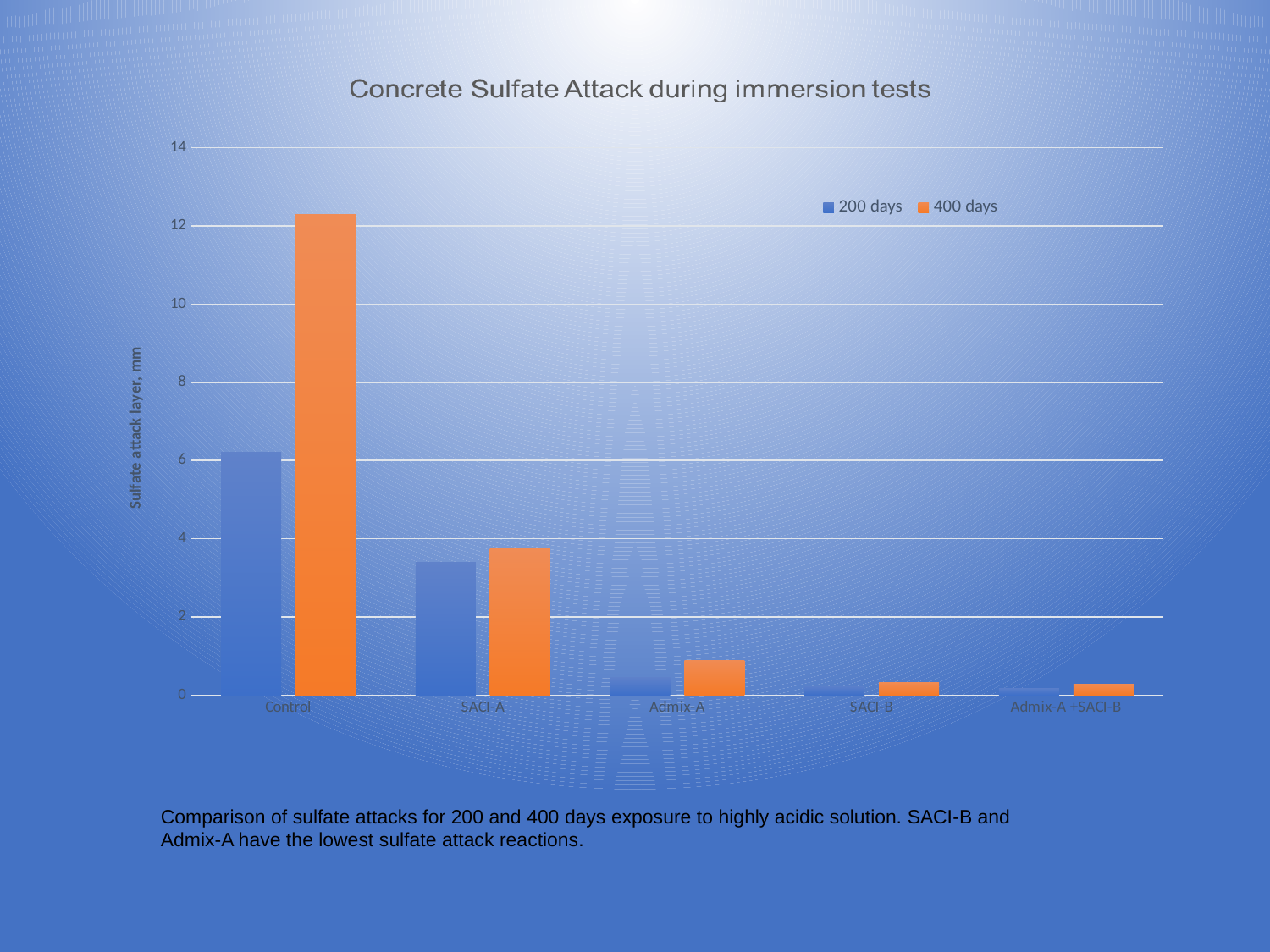
For Control, which is larger: the 200 days value or the 400 days value? 400 days What kind of chart is shown on the slide? bar chart Which category has the highest 400 days bar? Control Is the 200 days value for Control greater or less than 6? greater Is the 400 days value for Admix-A greater or less than 2? less What is the label of the chart's vertical axis? Sulfate attack layer, mm Which is larger: the 400 days value for SACI-A or the 400 days value for Admix-A? SACI-A How many series does the chart's legend list? 2 Which category has the highest 200 days bar? Control Is the 400 days value for SACI-A greater or less than 4? less How many categories are shown on the x axis of the chart? 5